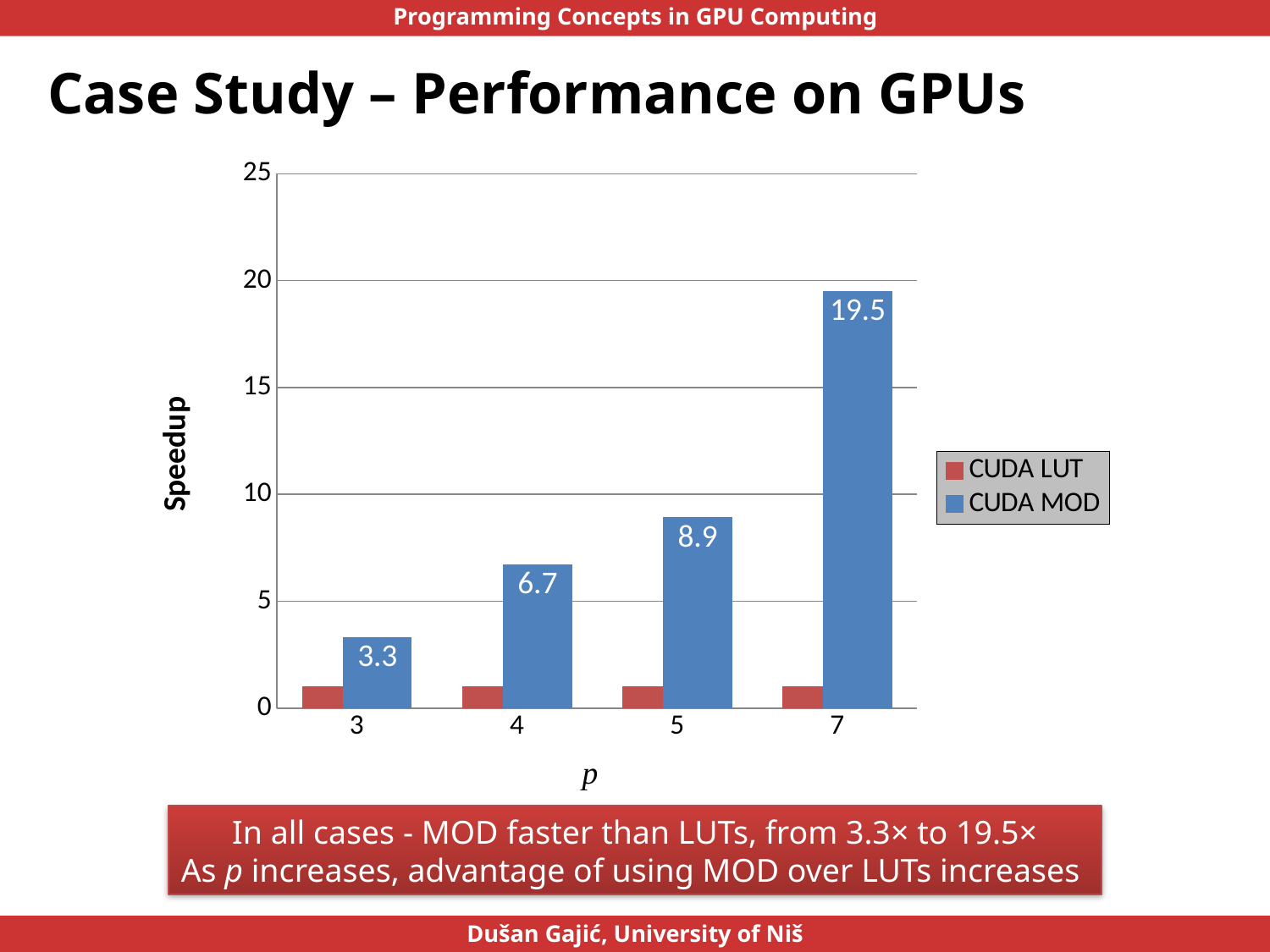
For which value of p is the CUDA MOD speedup lowest? 3 For which value of p is the CUDA MOD speedup highest? 7 How many values of p are shown on the x axis? 4 What is the difference between the CUDA MOD speedup at p = 7 and at p = 5? 10.6 How many series does the legend list? 2 What is the CUDA MOD speedup for p = 7? 19.5 What kind of chart is shown on the slide? bar chart What is the CUDA MOD speedup for p = 5? 8.9 What is the CUDA MOD speedup for p = 3? 3.3 What is the difference between the CUDA MOD speedup at p = 4 and at p = 3? 3.4 Which is larger, the CUDA MOD speedup at p = 4 or at p = 5? p = 5 Is the CUDA LUT speedup for p = 7 greater or less than 5? less